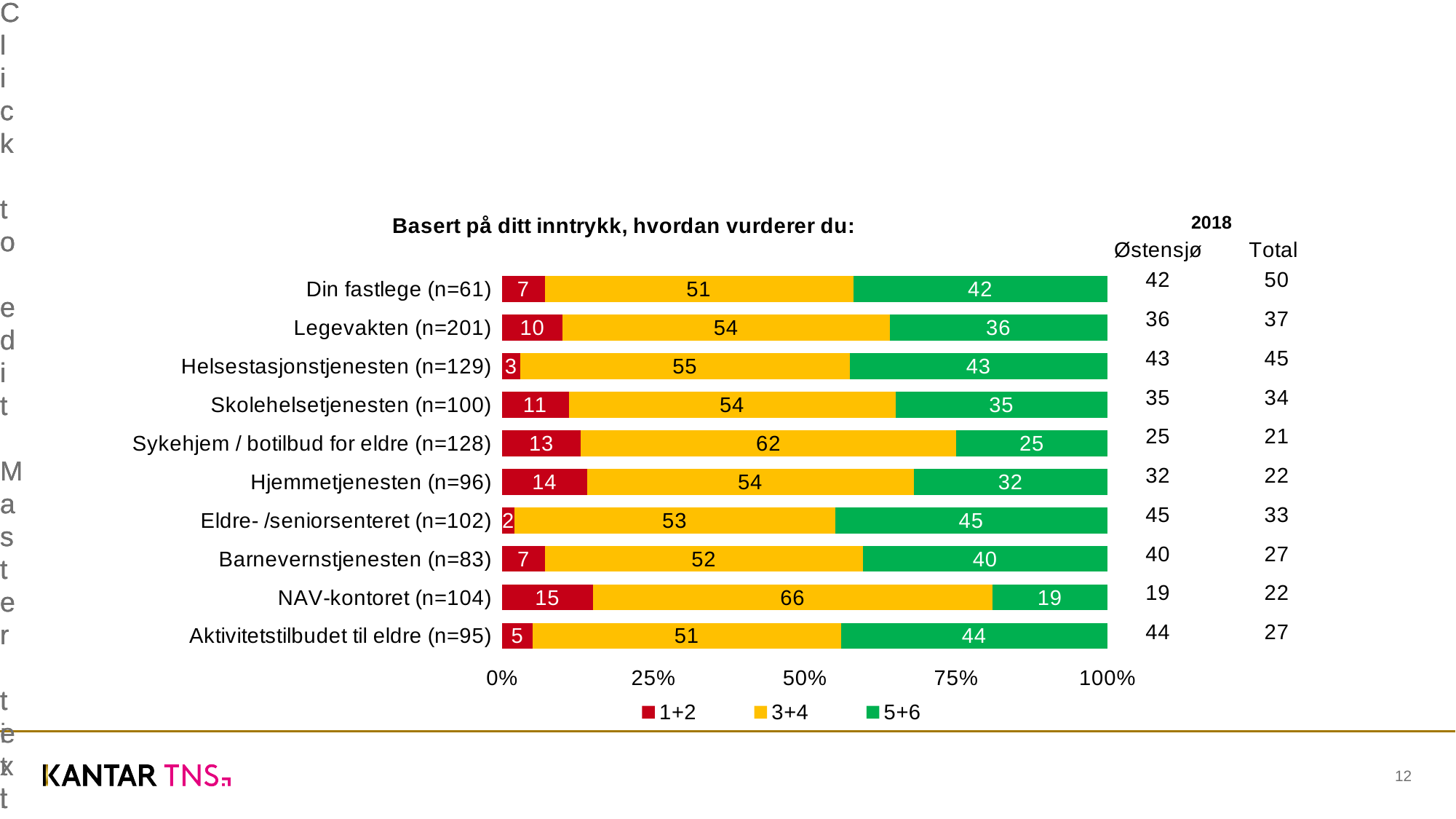
What is the title of the chart? Basert på ditt inntrykk, hvordan vurderer du: Which category has the lowest value in the 1+2 series? Eldre- /seniorsenteret (n=102) What is the value of the 3+4 series for NAV-kontoret (n=104)? 66 What is the value of the 5+6 series for Helsestasjonstjenesten (n=129)? 43 Which category has the highest value in the 5+6 series? Eldre- /seniorsenteret (n=102) What is the difference between the 3+4 values for NAV-kontoret (n=104) and Din fastlege (n=61)? 15 What kind of chart is shown on the slide? Stacked bar chart What is the total of the stacked bar for Sykehjem / botilbud for eldre (n=128)? 100 What is the value of the 1+2 series for Hjemmetjenesten (n=96)? 14 How many categories are shown on the chart? 10 How many series does the legend list? 3 Which is larger: the 5+6 value for Legevakten (n=201) or for Barnevernstjenesten (n=83)? Barnevernstjenesten (n=83)